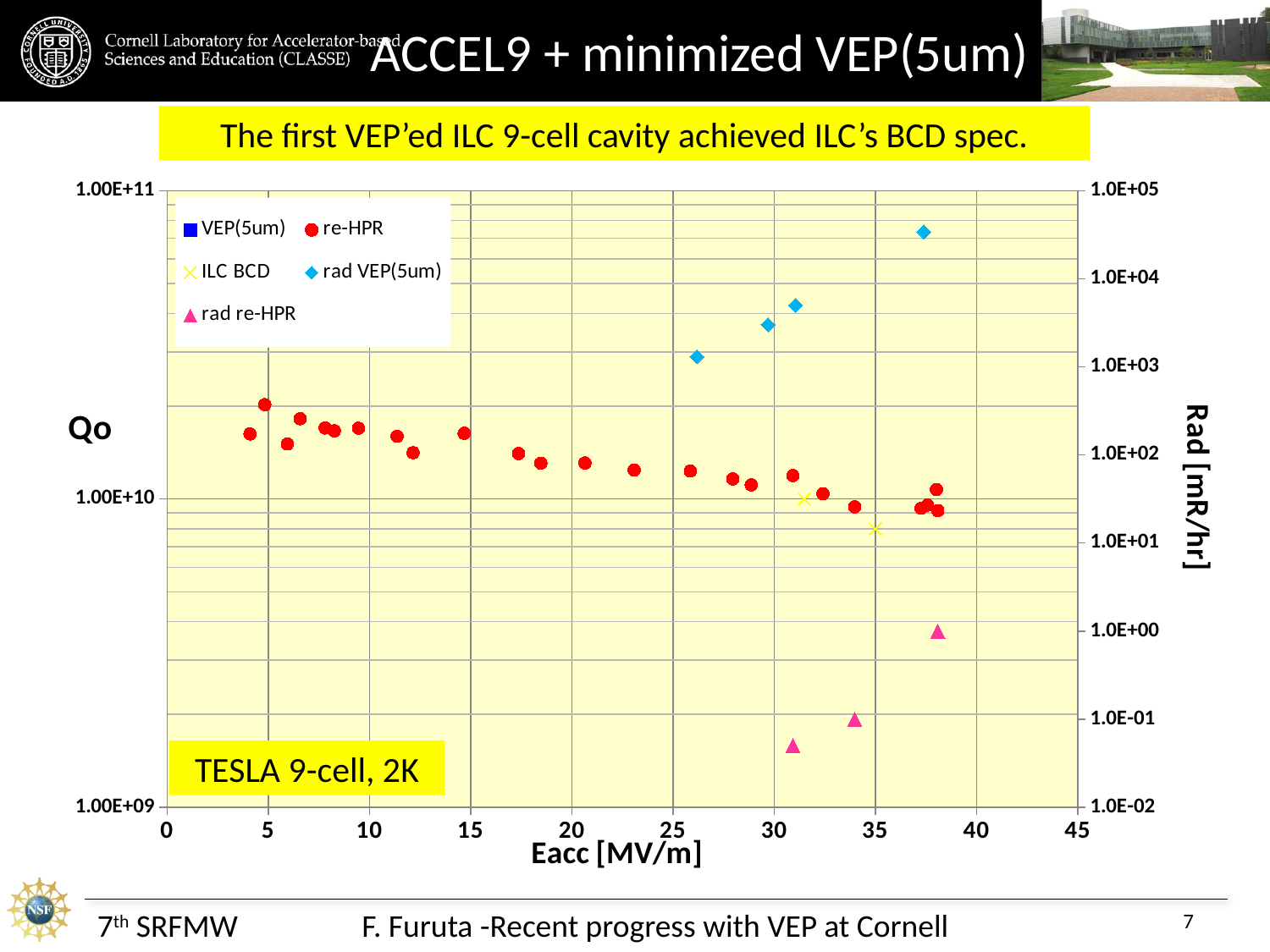
How many rad VEP(5um) points are plotted on the chart? 4 What kind of chart is shown on the slide? scatter chart How many series does the chart legend list? 5 How many rad re-HPR points are plotted on the chart? 3 What is the label of the right-hand y axis of the chart? Rad [mR/hr] Is the highest rad VEP(5um) value greater or less than 1.0E+04 mR/hr? greater How many ILC BCD points are plotted on the chart? 2 What is the label of the x axis of the chart? Eacc [MV/m] Does the Qo of the re-HPR series rise or fall as Eacc increases? fall Is the lowest rad re-HPR value greater or less than 1.0E-01 mR/hr? less Which series reaches higher radiation values, rad VEP(5um) or rad re-HPR? rad VEP(5um) Does the radiation of the rad VEP(5um) series rise or fall as Eacc increases? rise